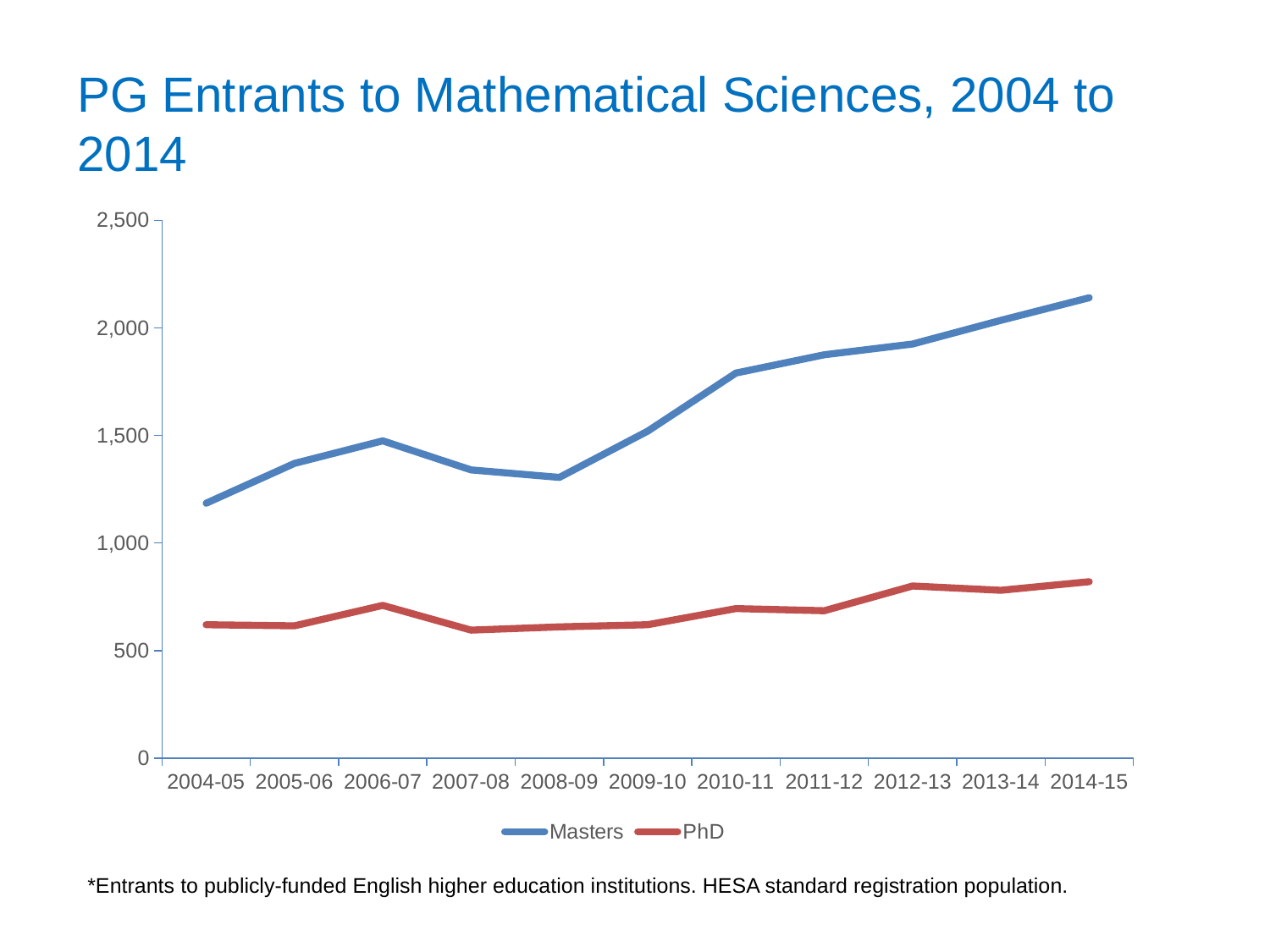
In which year is the Masters series at its lowest? 2004-05 What colour is the PhD line? red Is the value for PhD in 2014-15 greater or less than 1,000? less What type of chart is shown on the slide? line chart How many series does the legend list? 2 Is the value for Masters in 2004-05 greater or less than 1,000? greater Which series is larger in 2009-10, Masters or PhD? Masters How many academic years are plotted along the x axis? 11 In which year is the Masters series at its highest? 2014-15 Is the value for Masters in 2014-15 greater or less than 2,000? greater Overall, do Masters entrants rise or fall from 2004-05 to 2014-15? rise